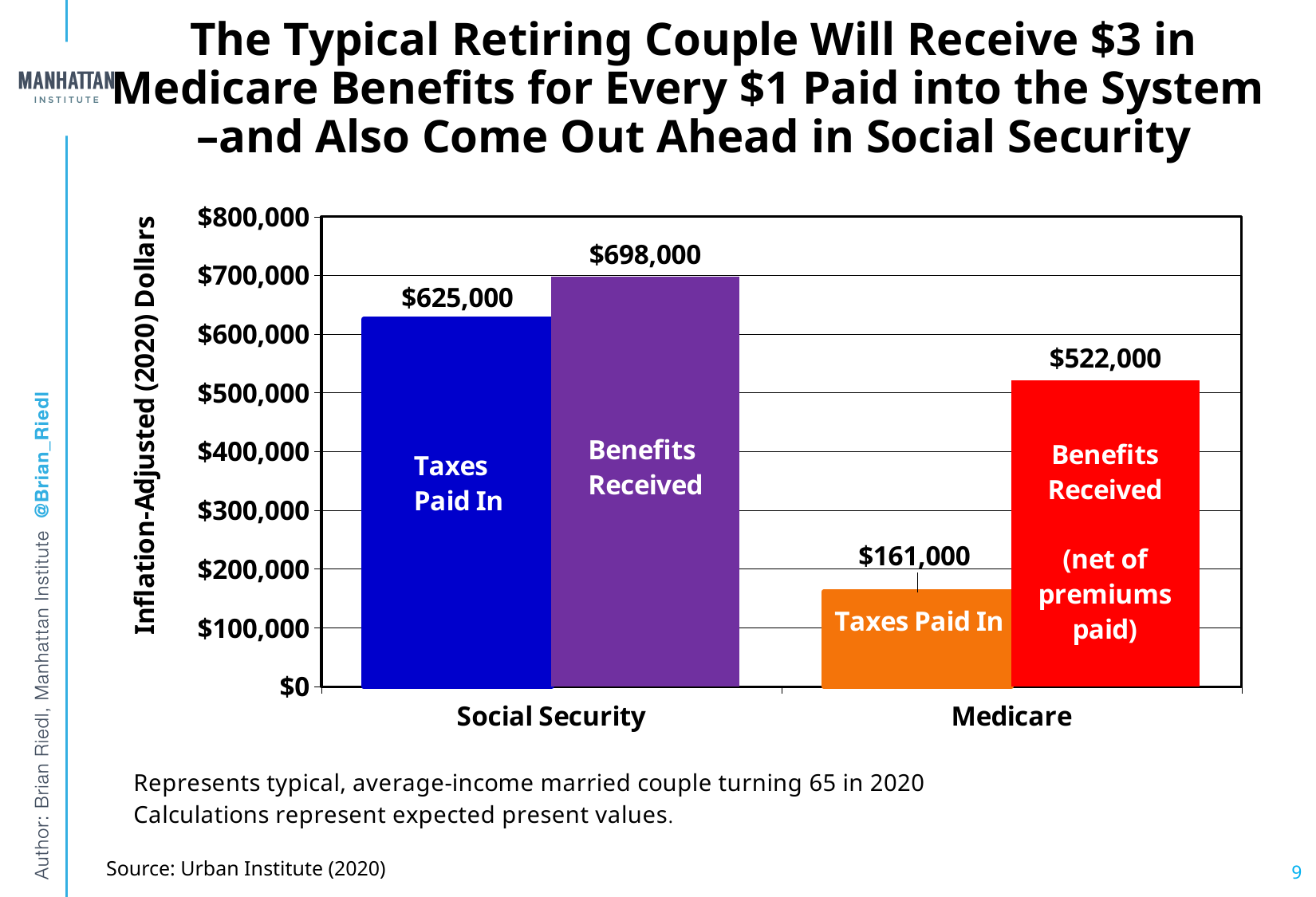
Which is larger for Social Security: Taxes Paid In or Benefits Received? Benefits Received Is the value for Medicare Taxes Paid In greater or less than $200,000? less Which bar has the lowest value on the chart? Medicare Taxes Paid In What is the value of Benefits Received for Social Security? $698,000 Which bar has the highest value on the chart? Social Security Benefits Received What is the value of Benefits Received (net of premiums paid) for Medicare? $522,000 What is the value of Taxes Paid In for Social Security? $625,000 What is the difference between Benefits Received and Taxes Paid In for Medicare? $361,000 What is the label of the vertical axis? Inflation-Adjusted (2020) Dollars What is the difference between Benefits Received and Taxes Paid In for Social Security? $73,000 What kind of chart is shown on the slide? Bar chart What is the value of Taxes Paid In for Medicare? $161,000